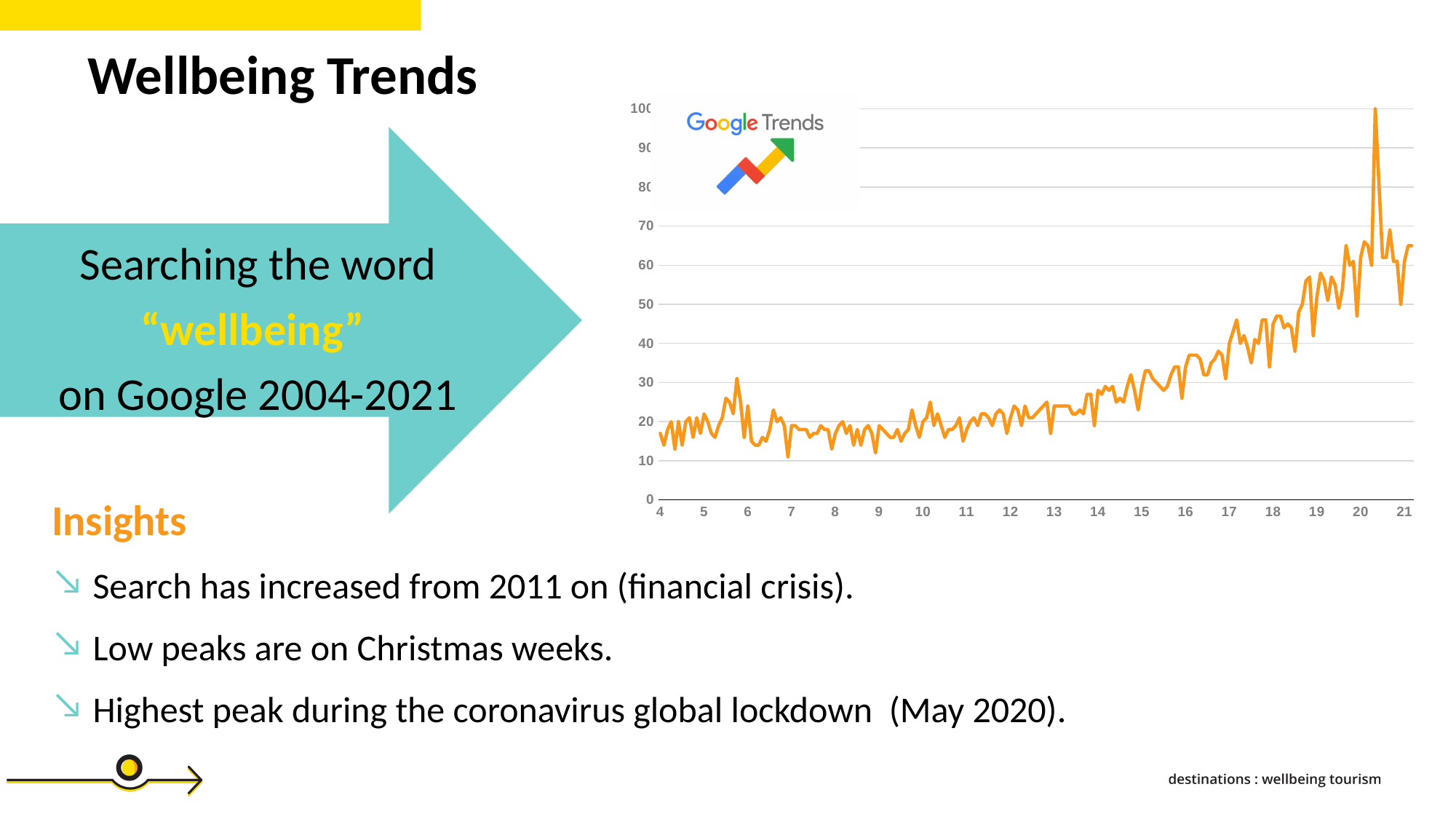
How many year labels are shown on the x axis? 18 What is the highest value shown on the y axis? 100 What kind of chart is shown on the slide? line chart What is the highest value reached by the line on the chart? 100 Is the value for 2008 greater or less than 30? less Which year has higher search interest, 2008 or 2018? 2018 Which year has higher search interest, 2005 or 2020? 2020 What colour is the line on the chart? orange Overall, do the values rise or fall along the x axis from 2004 to 2021? rise Is the value for 2015 greater or less than 40? less Is the value for 2021 at the end of the line greater or less than 50? greater In which year does the search interest line reach its highest peak? 2020